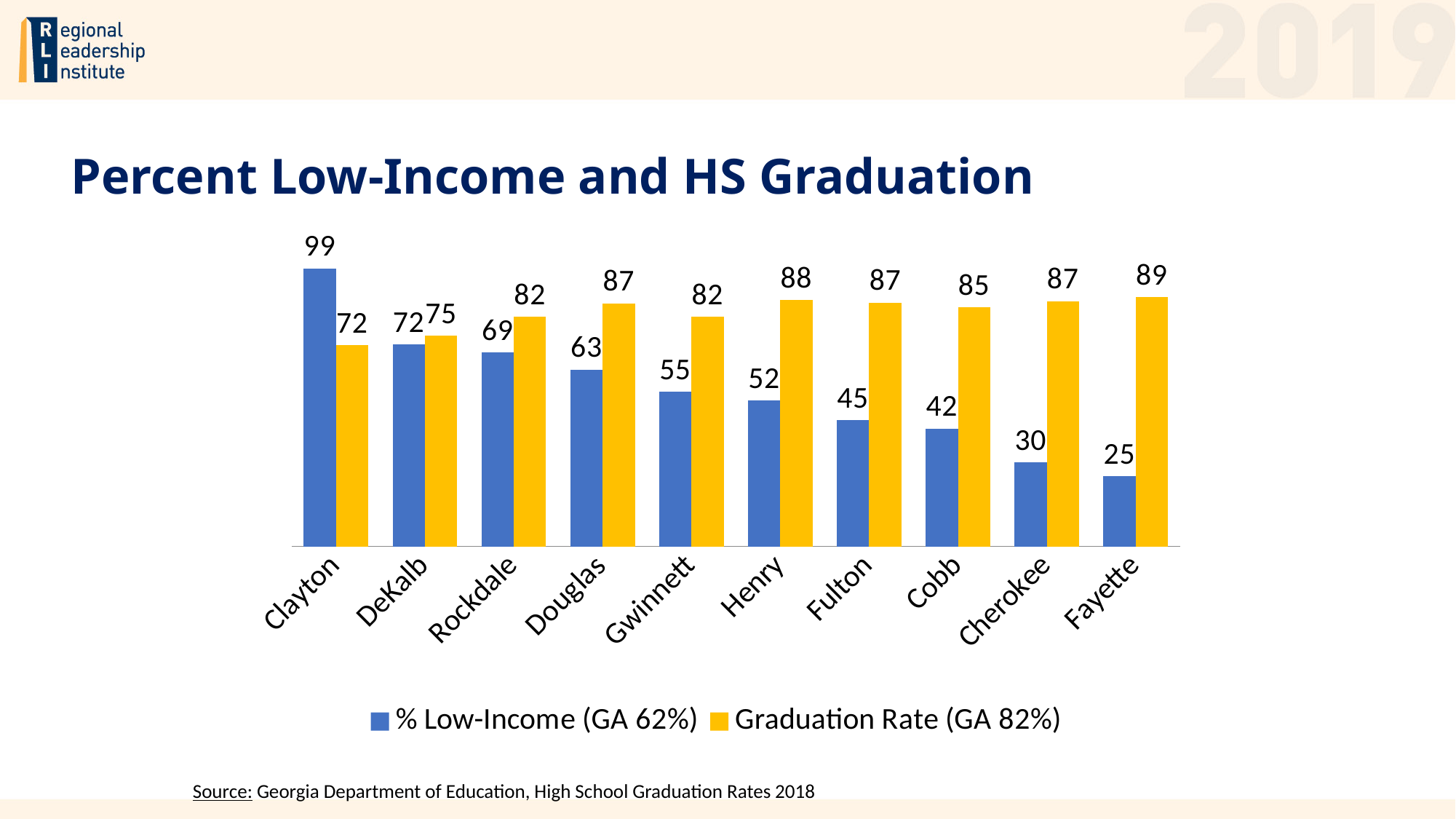
What is the % Low-Income value for Cherokee? 30 How many series does the legend list? 2 What kind of chart is shown on the slide? Bar chart What is the title of the chart? Percent Low-Income and HS Graduation What is the difference between the Graduation Rate and the % Low-Income value for Fayette? 64 What is the Graduation Rate for Fayette? 89 Which county has the lowest Graduation Rate? Clayton Which county has the highest % Low-Income value? Clayton What is the % Low-Income value for Clayton? 99 Which is larger for Clayton: the % Low-Income value or the Graduation Rate? % Low-Income How many counties are shown on the chart? 10 Which county has the lowest % Low-Income value? Fayette